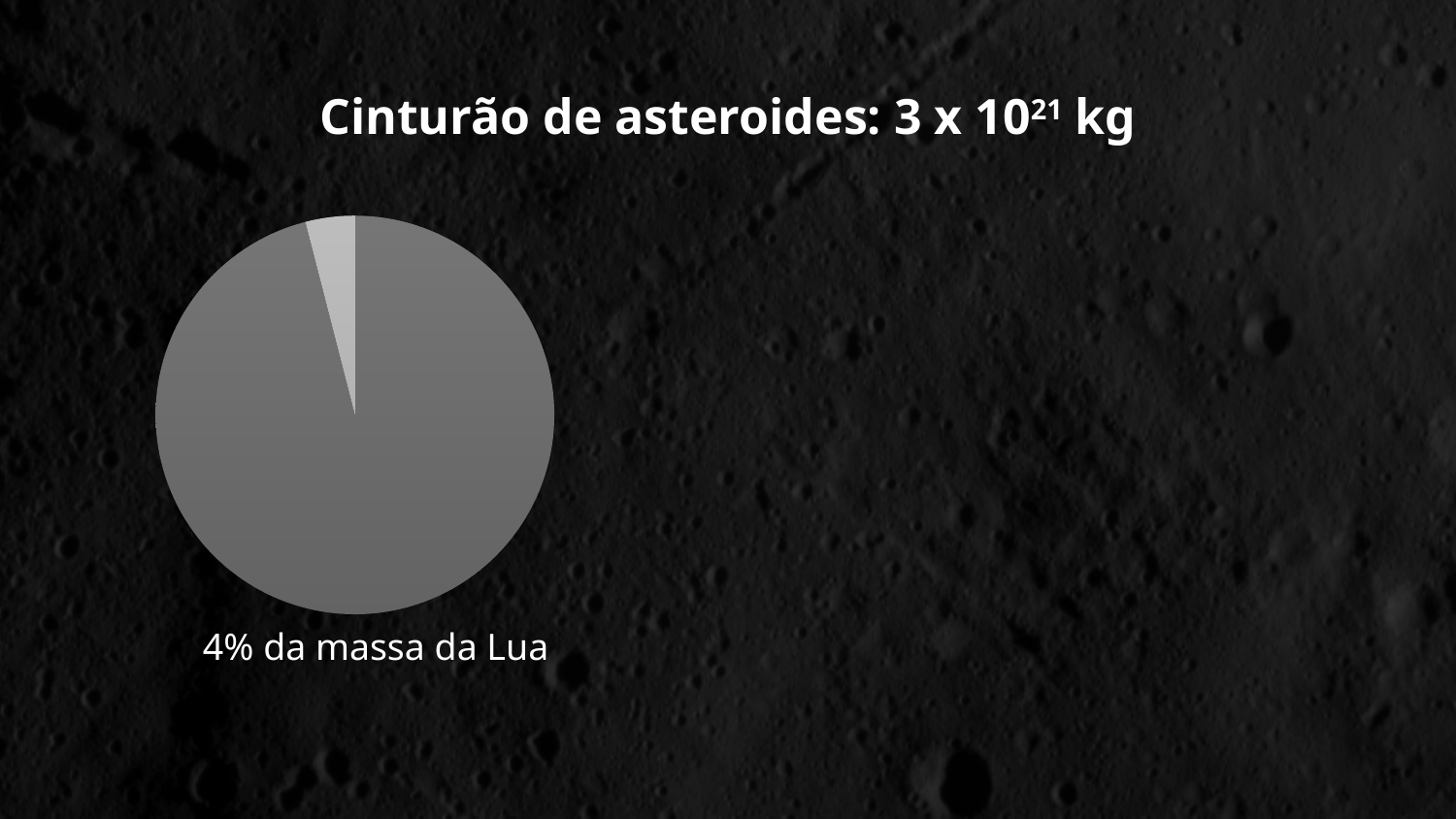
Which slice of the pie chart is the largest? the dark grey slice How many slices does the pie chart have? 2 What text is written below the pie chart? 4% da massa da Lua Is the light grey slice of the pie chart greater or less than 50% of the pie? less Which slice of the pie chart is the smallest? the light grey slice According to the caption below the pie chart, what share of the Moon's mass does the small slice represent? 4% What kind of chart is shown on the slide? pie chart What is the title shown above the pie chart? Cinturão de asteroides: 3 x 10²¹ kg Which slice of the pie chart is larger, the dark grey slice or the light grey slice? the dark grey slice Is the dark grey slice of the pie chart greater or less than 50% of the pie? greater